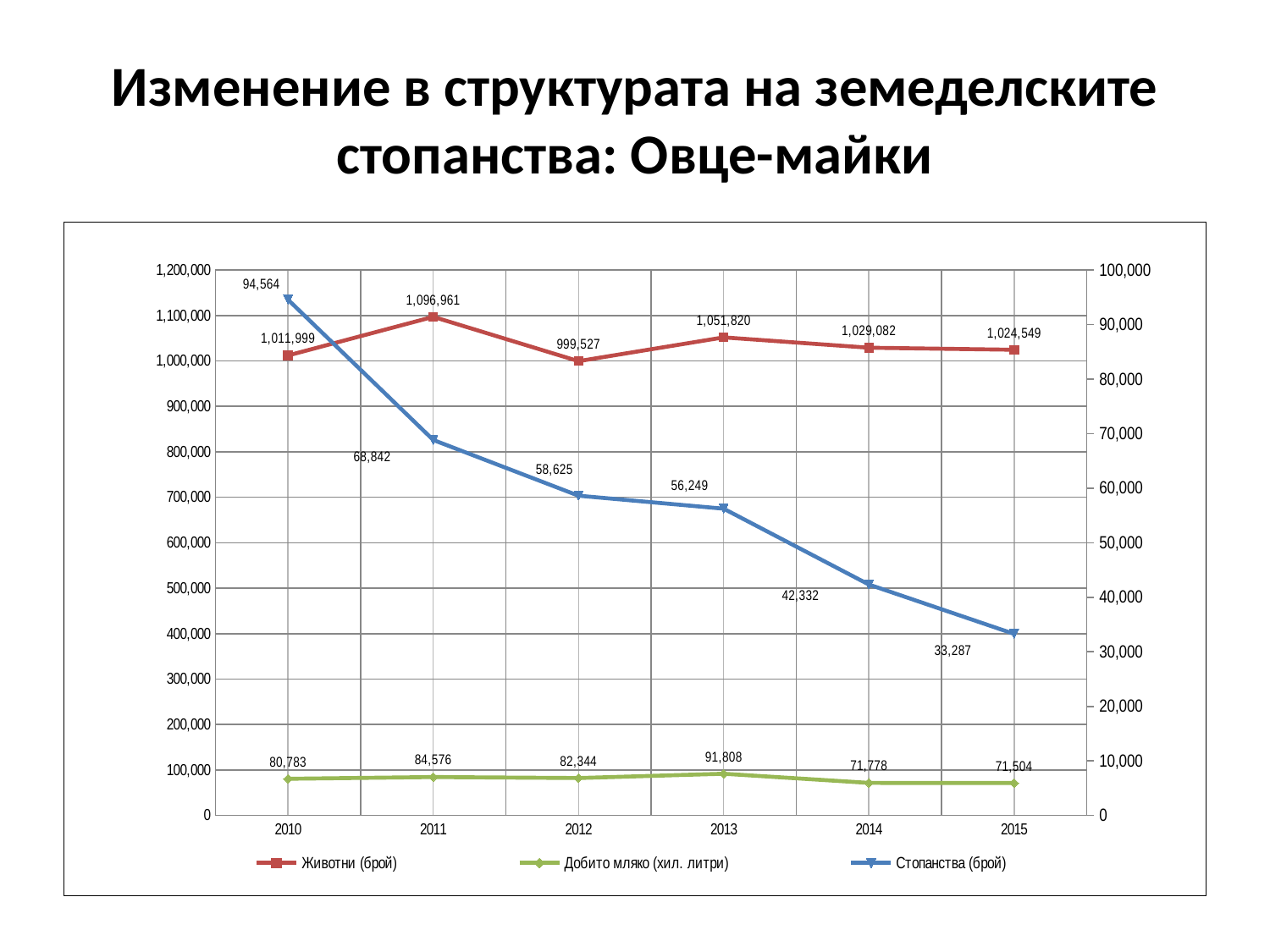
What is the value of Стопанства (брой) in 2015? 33,287 Which series is drawn in blue? Стопанства (брой) What is the value of Добито мляко (хил. литри) in 2013? 91,808 How many series does the legend list? 3 Which is larger: Добито мляко (хил. литри) in 2011 or in 2014? 2011 What is the value of Животни (брой) in 2011? 1,096,961 How many years are plotted along the x axis? 6 What is the difference between Стопанства (брой) in 2010 and in 2015? 61,277 In which year is Животни (брой) lowest? 2012 Does Стопанства (брой) rise or fall from 2010 to 2015? fall What type of chart is shown on the slide? line chart In which year is Стопанства (брой) highest? 2010